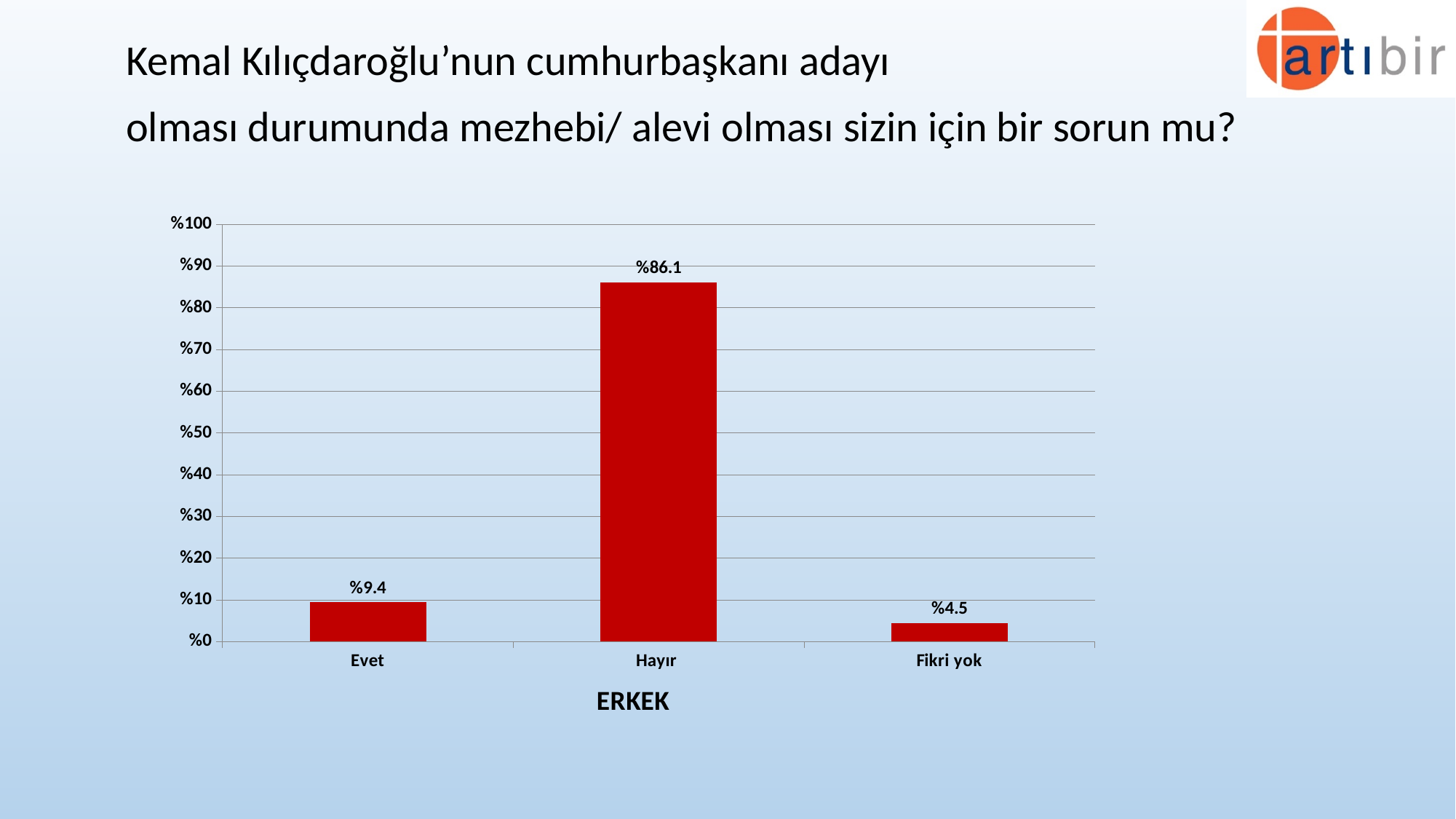
Which is larger, the value for Evet or the value for Fikri yok? Evet What is the difference between the values for Hayır and Evet? %76.7 What is the value for Fikri yok? %4.5 What label appears below the x axis of the chart? ERKEK Which category has the highest value? Hayır Which category has the lowest value? Fikri yok What is the value for Hayır? %86.1 What kind of chart is shown on the slide? bar chart How many categories are shown on the x axis? 3 What is the value for Evet? %9.4 What is the difference between the values for Evet and Fikri yok? %4.9 Is the value for Hayır greater or less than %80? greater